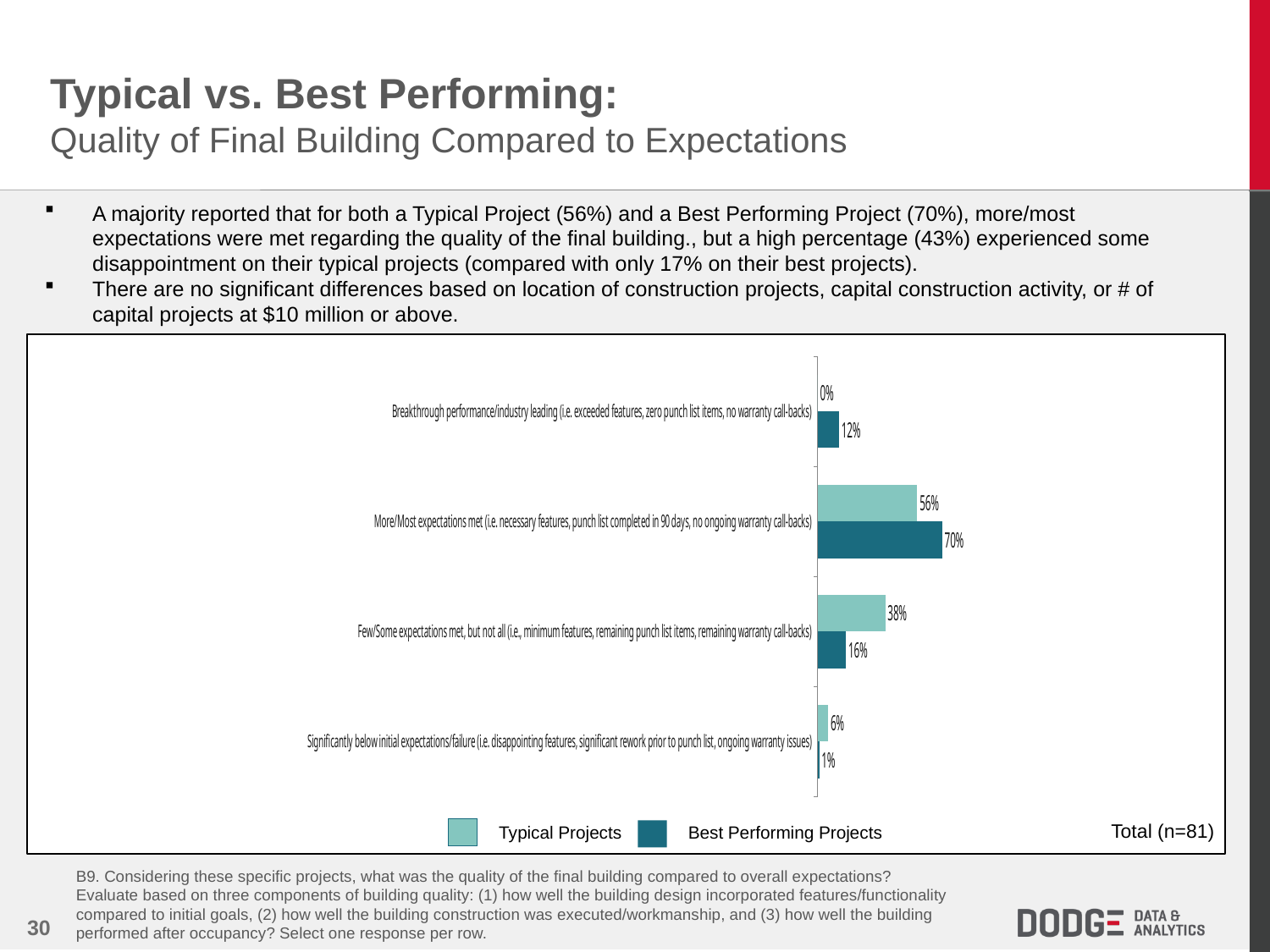
What is the difference between Best Performing Projects and Typical Projects in the 'More/Most expectations met' category? 14% How many series does the legend list? 2 Which category has the lowest value for Typical Projects? Breakthrough performance/industry leading Which category has the highest value for Best Performing Projects? More/Most expectations met What is the value for Best Performing Projects in the 'More/Most expectations met' category? 70% What kind of chart is shown on the slide? Bar chart How many categories are plotted in the chart? 4 What is the value for Typical Projects in the 'More/Most expectations met' category? 56% In the 'Few/Some expectations met, but not all' category, which series has the larger value, Typical Projects or Best Performing Projects? Typical Projects What is the value for Typical Projects in the 'Few/Some expectations met, but not all' category? 38% What is the value for Best Performing Projects in the 'Breakthrough performance/industry leading' category? 12% What is the value for Best Performing Projects in the 'Significantly below initial expectations/failure' category? 1%